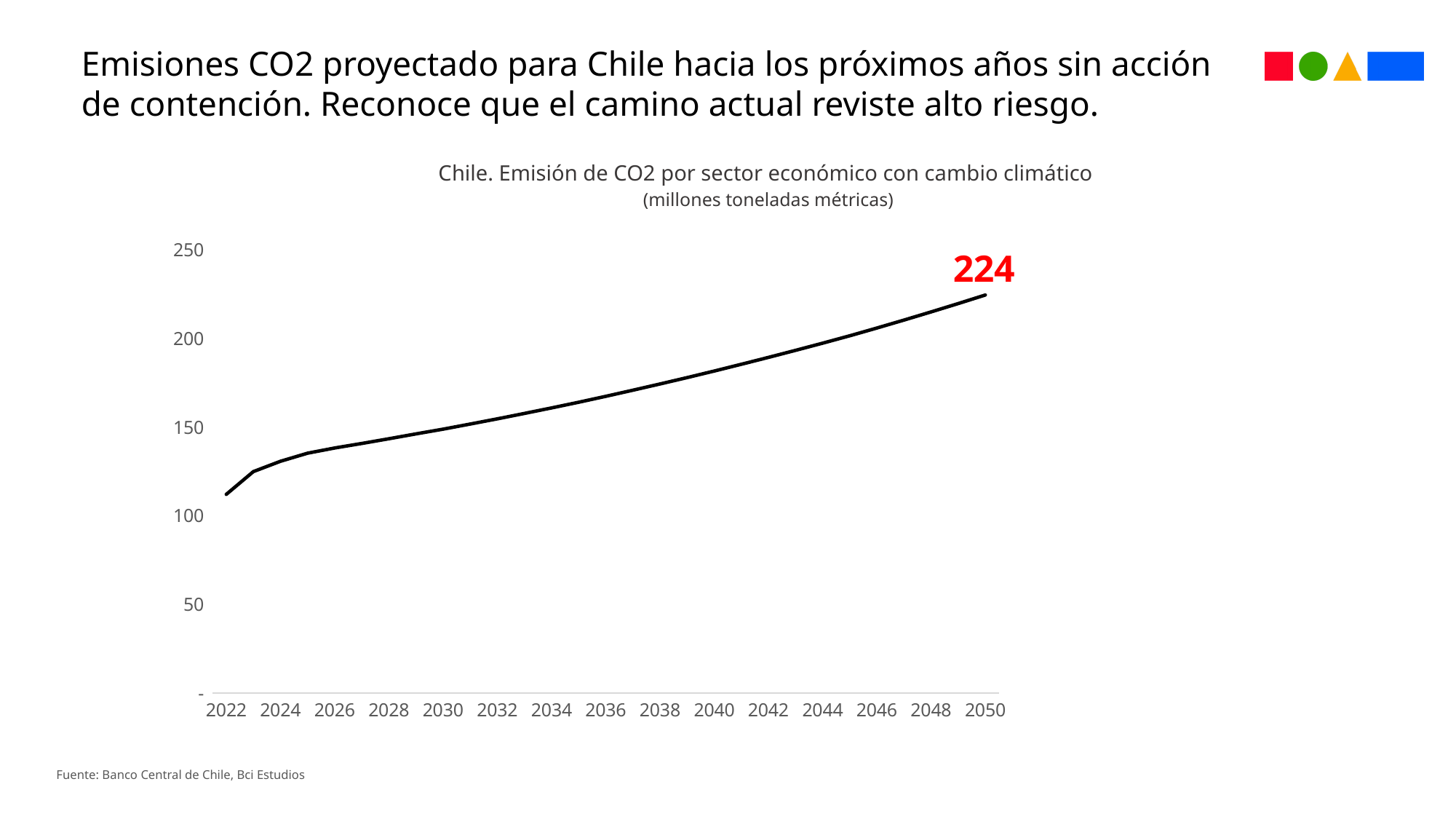
Which is larger, the value for 2050 or the value for 2022? 2050 Is the value for 2022 greater or less than 150? less What unit is given in the chart subtitle? millones toneladas métricas Which year has the highest value on the chart? 2050 What is the value shown for 2050 on the chart? 224 Is the value for 2046 greater or less than 200? greater Which year has the lowest value on the chart? 2022 What kind of chart is shown on the slide? Line chart Do the values rise or fall from 2022 to 2050? Rise What is the title of the chart? Chile. Emisión de CO2 por sector económico con cambio climático Is the value for 2040 greater or less than 150? greater